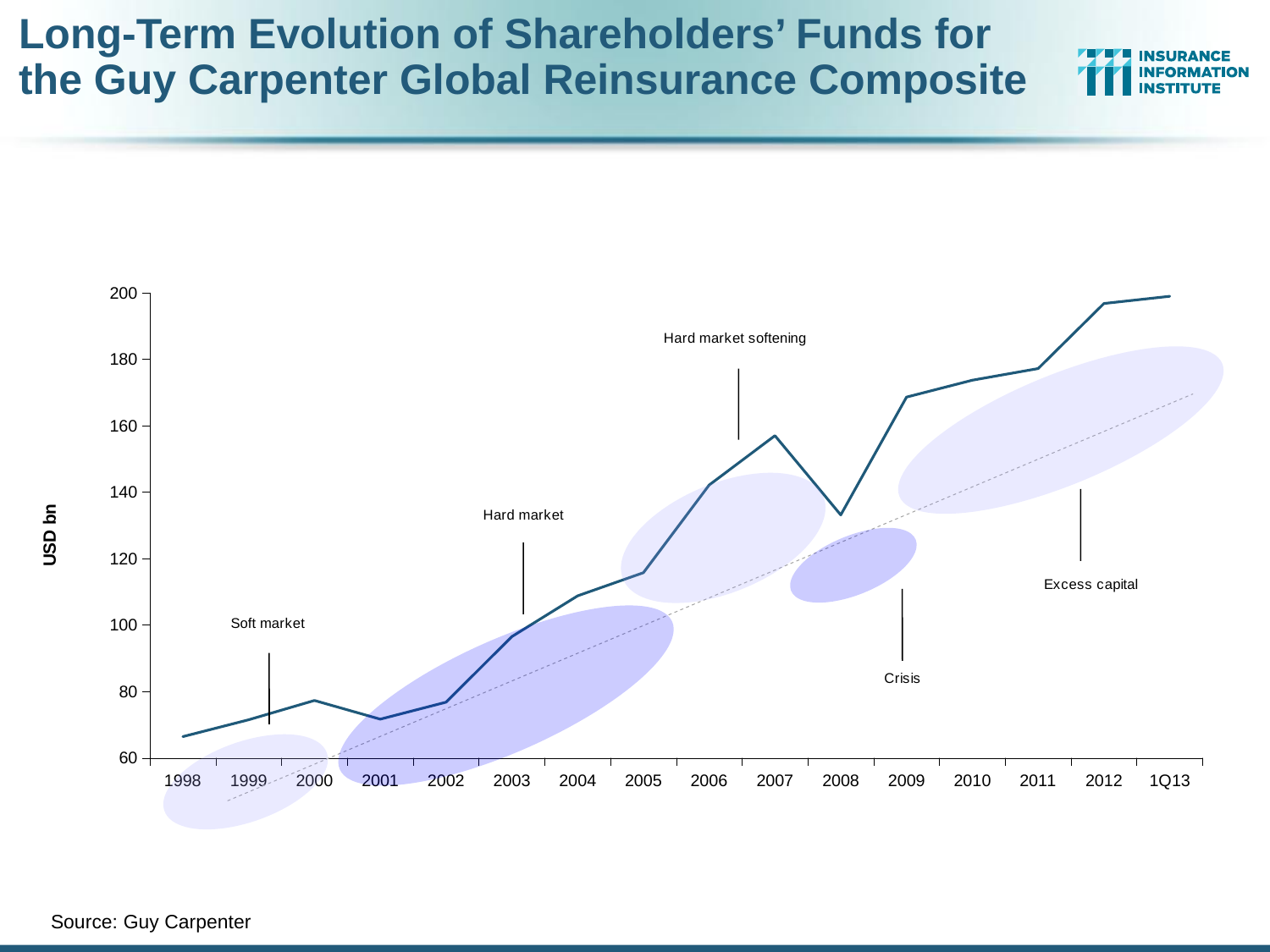
Is the value for 2008 greater or less than 140? less What is the source cited for the chart? Guy Carpenter What kind of chart is shown on the slide? line chart Is the value for 2012 greater or less than 180? greater Is the value for 2001 greater or less than 80? less What is the label on the vertical axis? USD bn Which year has the lowest value of shareholders' funds? 1998 Which is larger, the value for 2007 or the value for 2008? 2007 How many time points are plotted along the x axis? 16 Overall, do shareholders' funds rise or fall from 1998 to 1Q13? rise